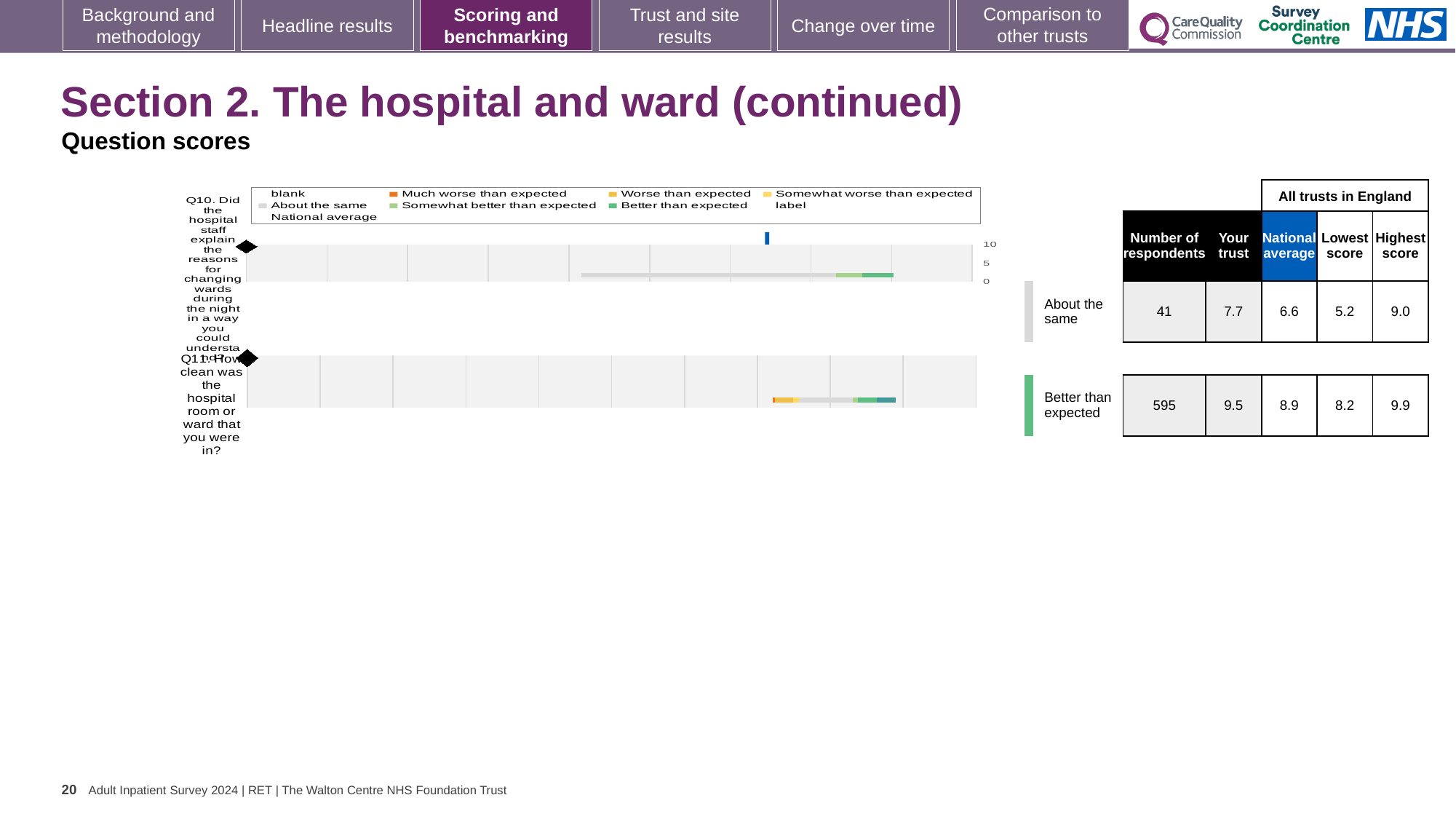
What is the 'Your trust' score for Q11 (how clean was the hospital room or ward)? 9.5 What benchmark category is Q10 rated as? About the same How many respondents answered Q11? 595 What is the national average score for Q10? 6.6 What benchmark category is Q11 rated as? Better than expected What is the national average score for Q11? 8.9 What is the highest score among all trusts in England for Q11? 9.9 What is the difference between the 'Your trust' score and the national average for Q11? 0.6 Which question has the higher 'Your trust' score, Q10 or Q11? Q11 What is the 'Your trust' score for Q10 (explaining reasons for changing wards during the night)? 7.7 What is the lowest score among all trusts in England for Q10? 5.2 What is the difference between the highest and lowest scores across all trusts in England for Q10? 3.8